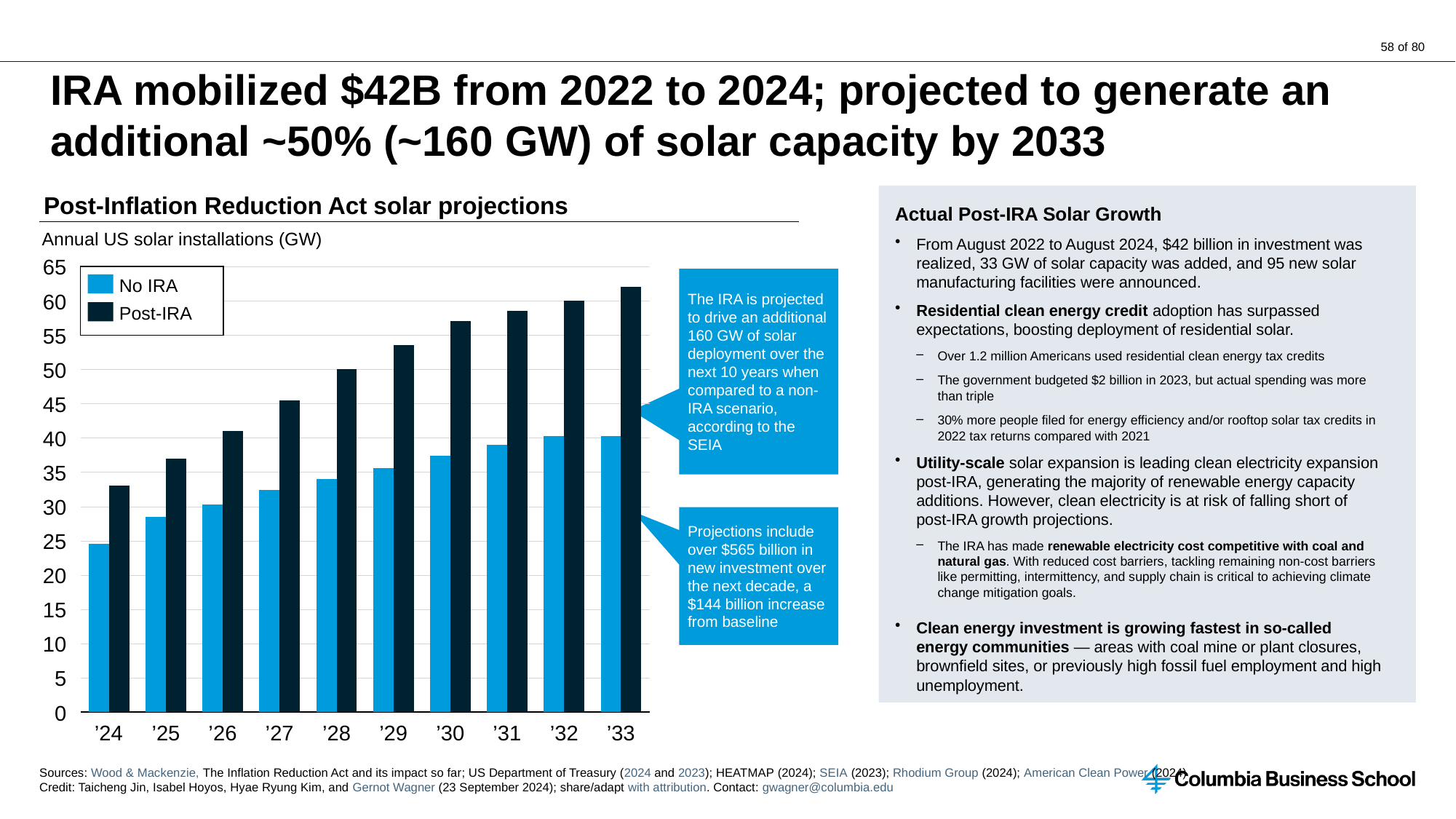
In '29, which series has the larger value, No IRA or Post-IRA? Post-IRA What is the title of the chart? Post-Inflation Reduction Act solar projections Is the Post-IRA value for '30 greater or less than 55? greater How many series does the chart legend list? 2 Which year has the lowest No IRA value? '24 Is the Post-IRA value for '33 greater or less than 60? greater What kind of chart is shown on the slide? bar chart What are the two series named in the chart legend? No IRA and Post-IRA Which year has the highest Post-IRA value? '33 How many years are shown along the x axis of the chart? 10 Do the Post-IRA values rise or fall from '24 to '33? rise